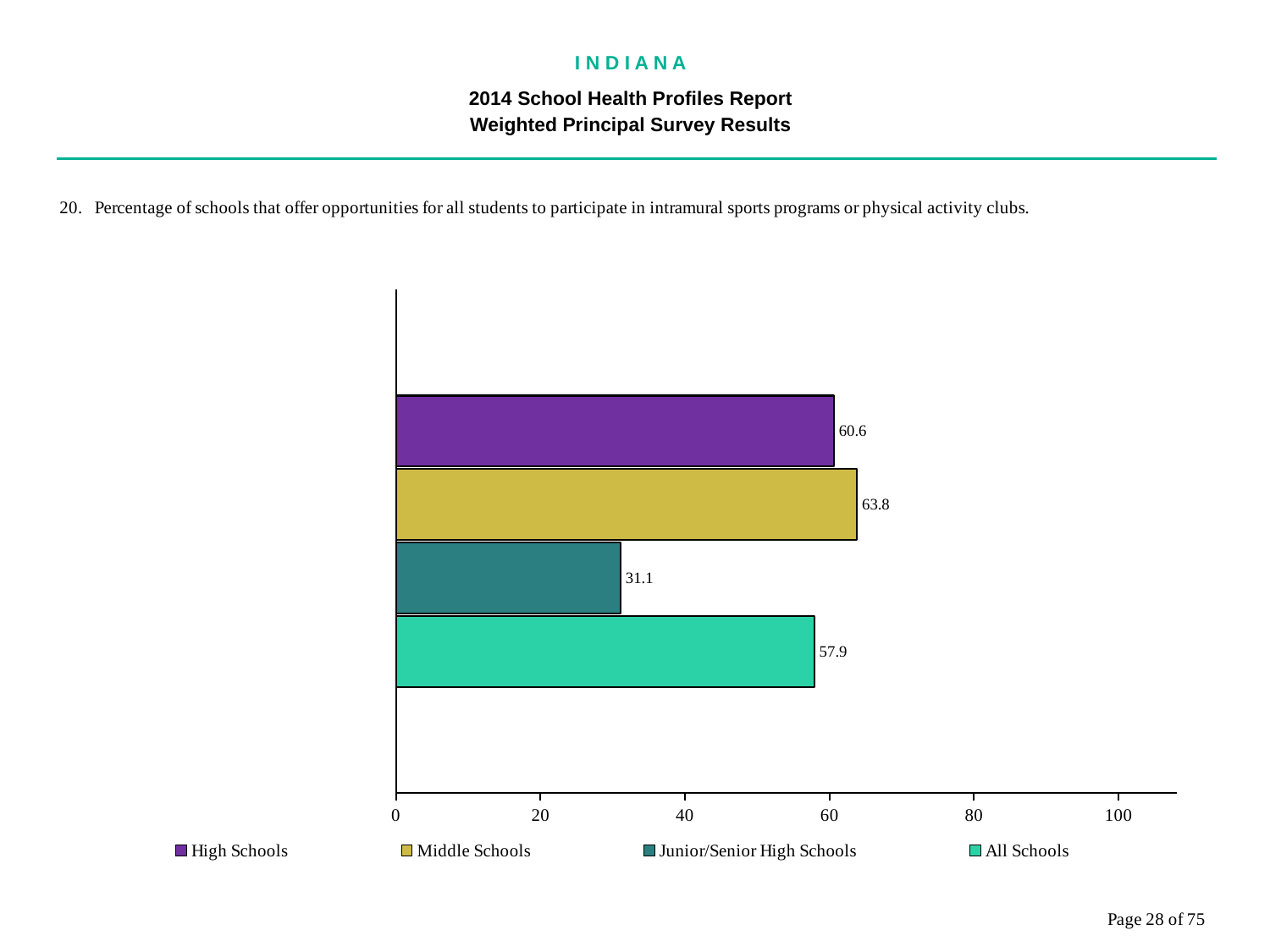
What is the value for High Schools? 60.6 Which is larger, the value for High Schools or the value for Junior/Senior High Schools? High Schools What kind of chart is shown on the slide? bar chart What is the difference between the values for Middle Schools and Junior/Senior High Schools? 32.7 How many series does the legend list? 4 Is the value for All Schools greater or less than 40? greater What is the value for All Schools? 57.9 What is the value for Middle Schools? 63.8 Which school type has the lowest value? Junior/Senior High Schools What is the difference between the values for High Schools and All Schools? 2.7 What is the value for Junior/Senior High Schools? 31.1 Which school type has the highest value? Middle Schools